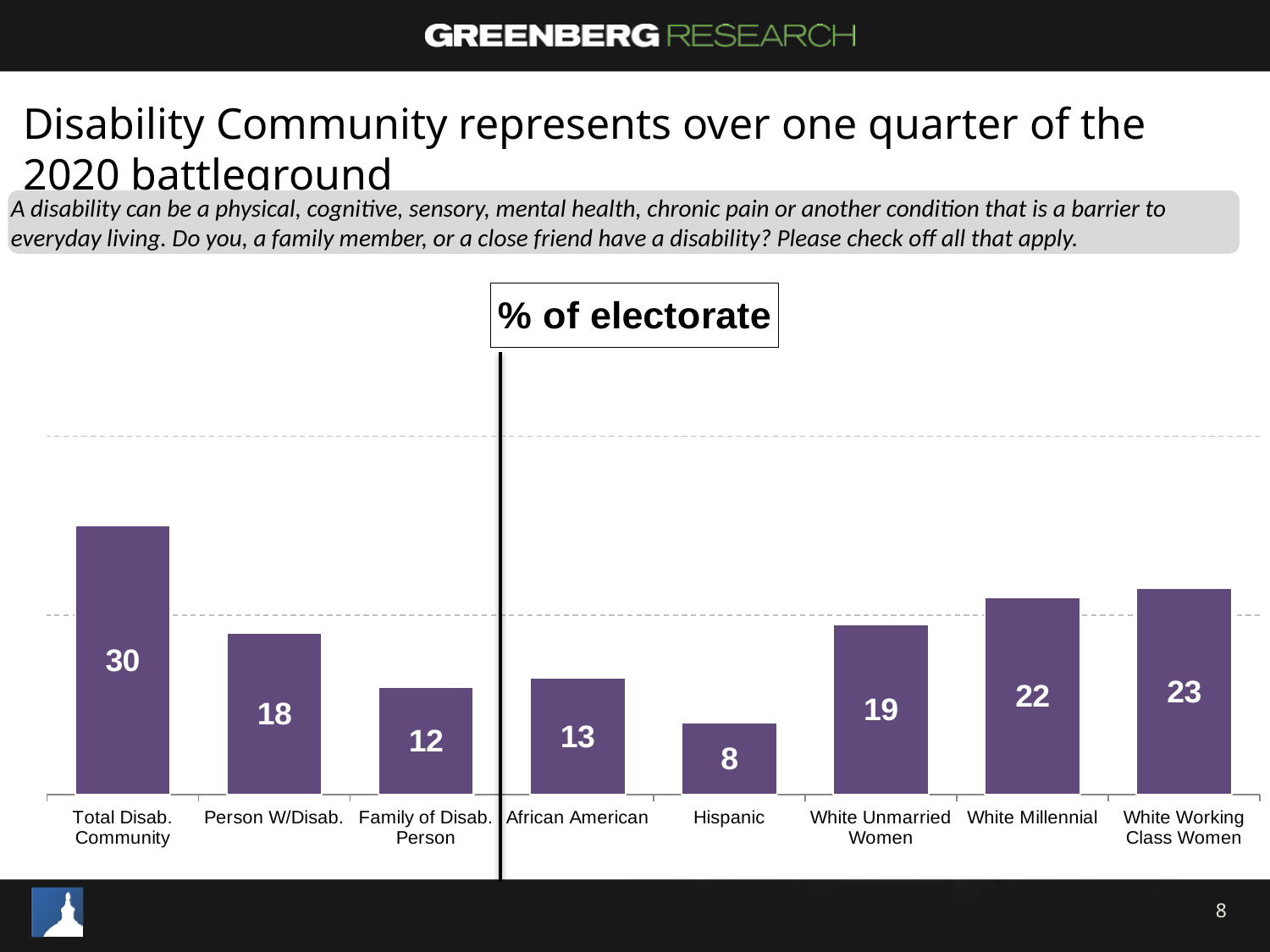
What is the difference between the values for Person W/Disab. and Family of Disab. Person? 6 Which category has the highest value? Total Disab. Community What is the value for White Unmarried Women? 19 Which category has the lowest value? Hispanic How many categories are shown in the chart? 8 Which is larger, the value for White Millennial or the value for African American? White Millennial What kind of chart is shown on the slide? Bar chart What is the difference between the values for Total Disab. Community and White Working Class Women? 7 What is the value for Family of Disab. Person? 12 What is the value for Hispanic? 8 What is the value for Total Disab. Community? 30 What is the title of the chart? % of electorate